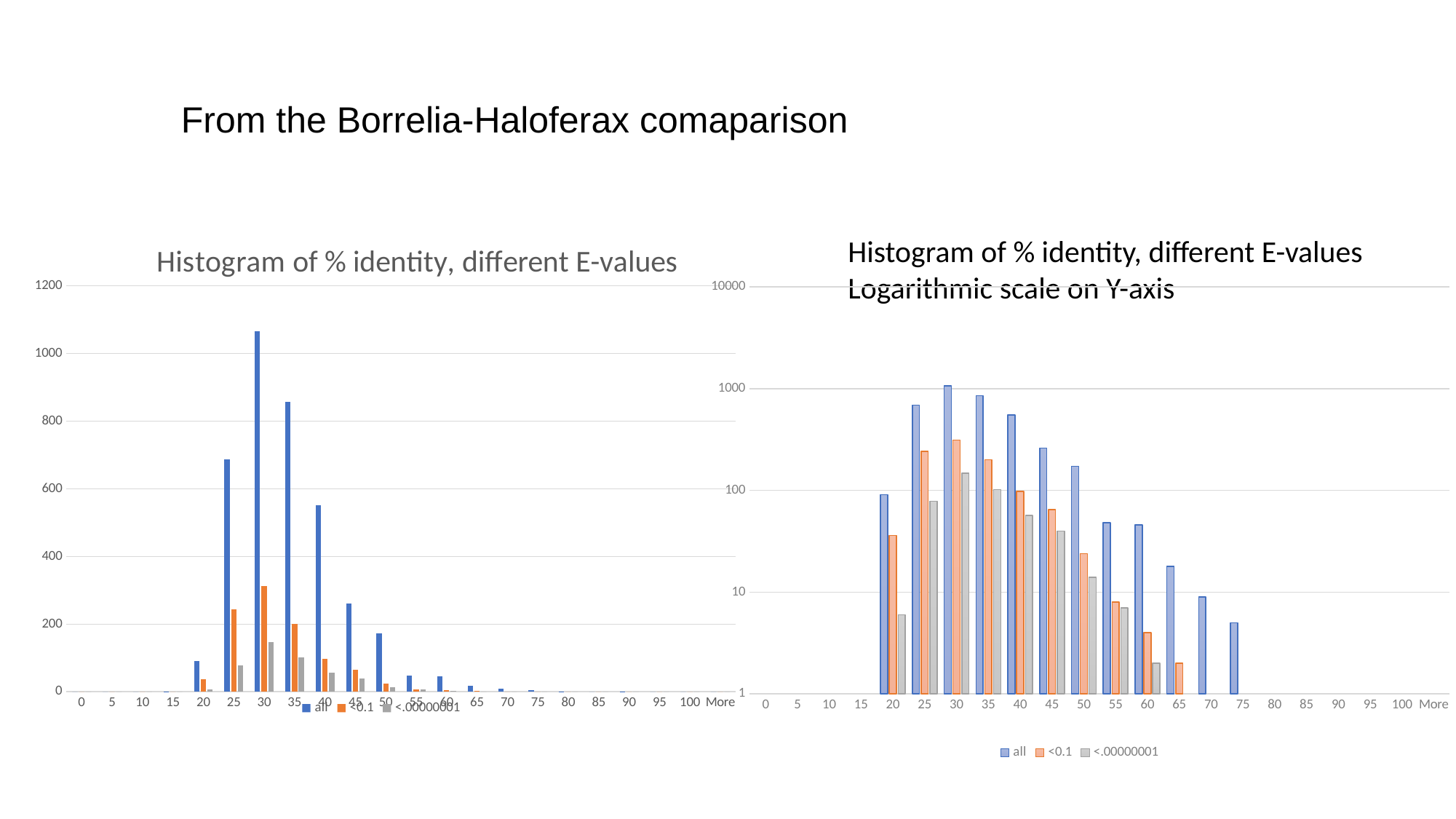
In the left chart, is the 'all' value at 30 greater or less than 1000? greater In the left chart, is the 'all' value at 40 greater or less than 600? less In the left chart, is the '<0.1' value at 30 greater or less than 200? greater In the left chart, at which x-axis category is the 'all' series highest? 30 How many series does the legend of the right chart (logarithmic scale) list? 3 In the left chart, which is larger for the 'all' series: the value at 30 or the value at 35? 30 What is the title of the left chart? Histogram of % identity, different E-values What kind of chart is the left chart, 'Histogram of % identity, different E-values'? bar chart How many categories are shown on the x axis of the left chart? 22